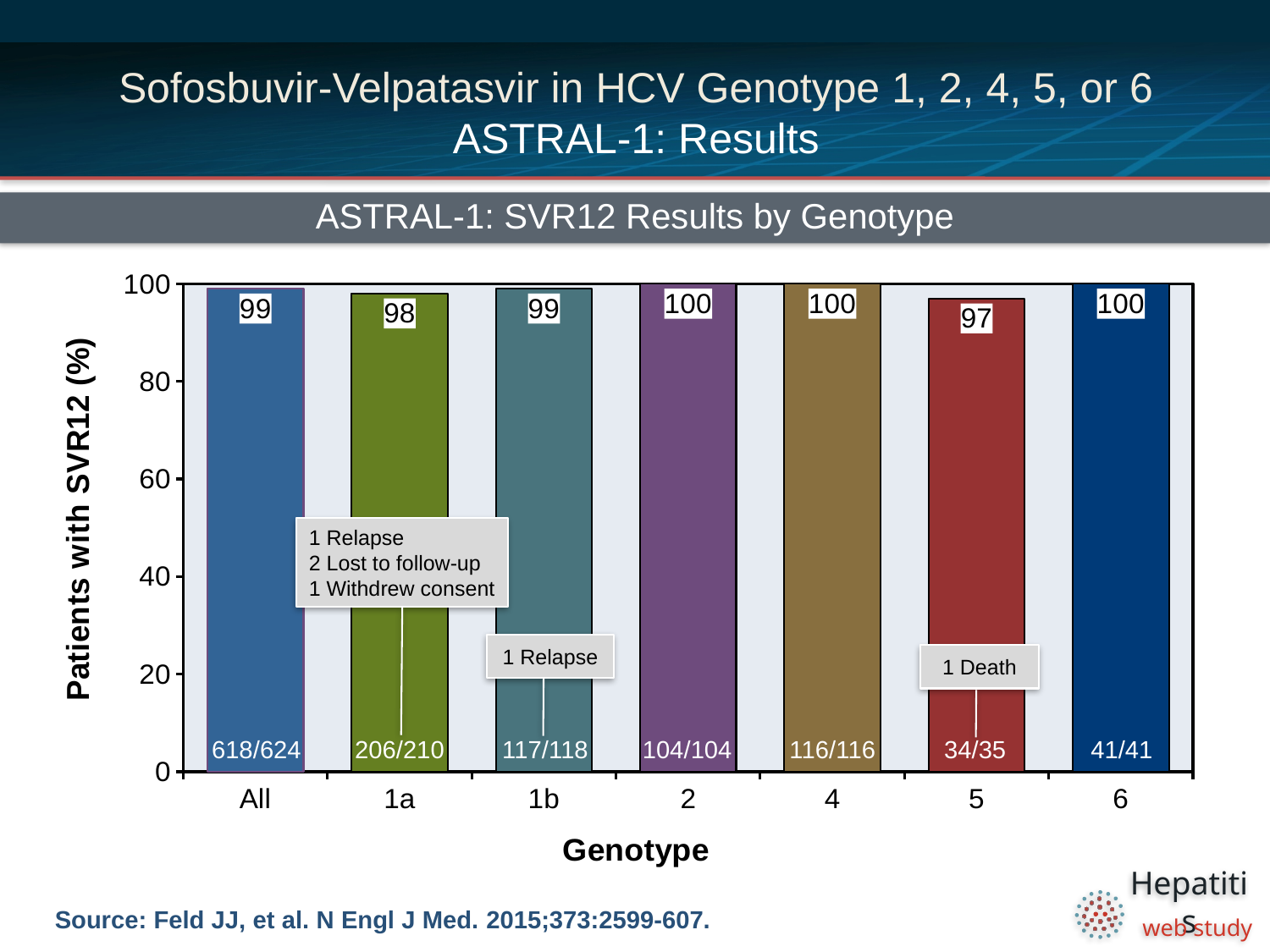
What is the difference in SVR12 rate between genotype 2 and genotype 5? 3 What is the SVR12 rate for genotype 5? 97 What fraction of patients is shown for genotype 1b? 117/118 What reason is given in the annotation for the genotype 5 bar? 1 Death Is the SVR12 rate for genotype 5 greater or less than 80? greater What is the label of the y axis? Patients with SVR12 (%) What is the SVR12 rate for genotype 1a? 98 What kind of chart is shown on the slide? Bar chart What fraction of patients is shown for the All group? 618/624 Which has a higher SVR12 rate, genotype 1a or genotype 6? Genotype 6 Which genotype has the lowest SVR12 rate? 5 How many genotype categories are shown on the x axis? 7